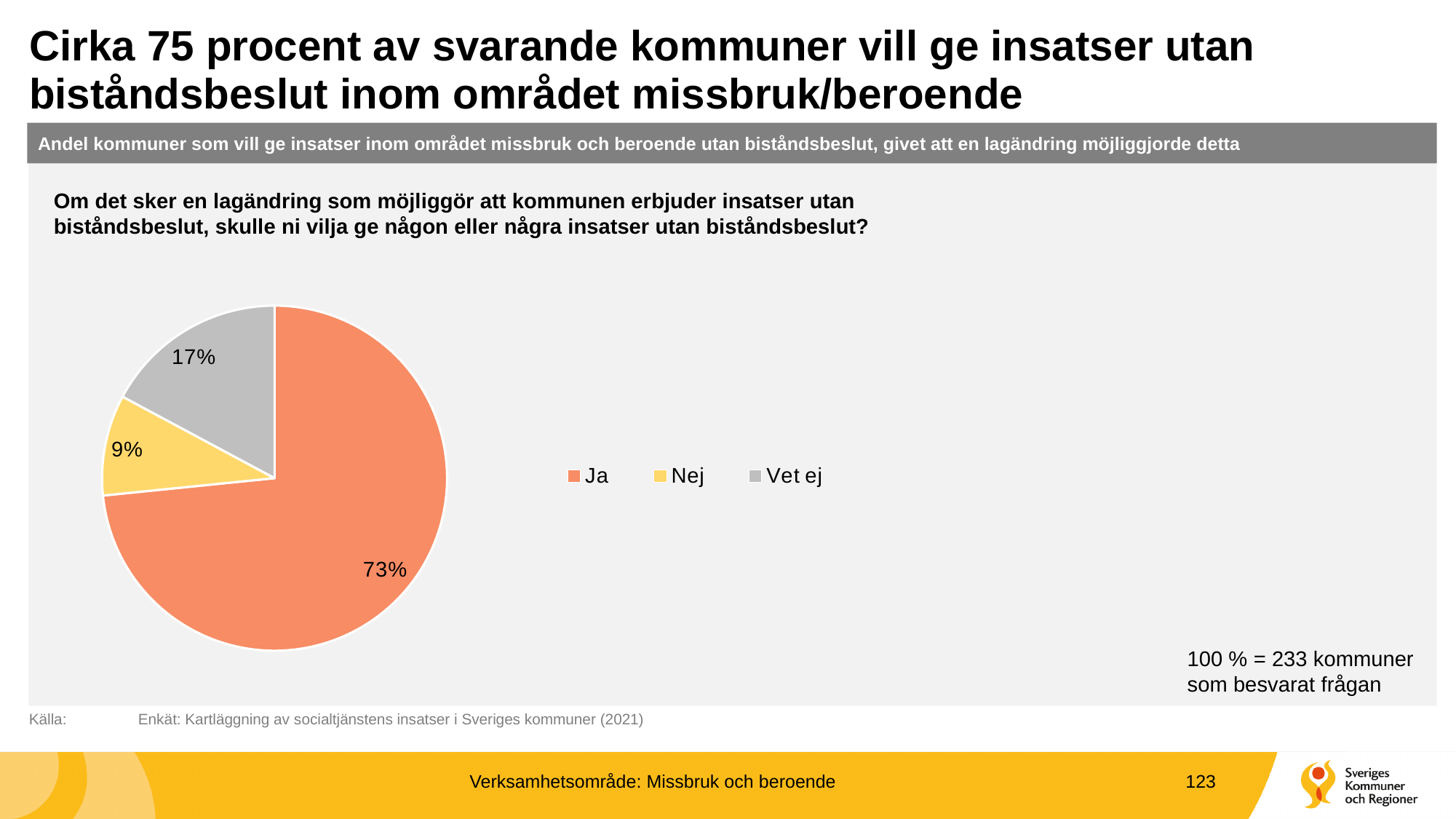
What share of the pie is labelled "Nej"? 9% Which is larger, the "Nej" slice or the "Vet ej" slice? Vet ej How many entries does the legend list? 3 What kind of chart is shown on the slide? pie chart How many slices does the pie chart have? 3 Which category has the largest slice of the pie? Ja Which category has the smallest slice of the pie? Nej What share of the pie is labelled "Ja"? 73% What share of the pie is labelled "Vet ej"? 17% What colour is the "Ja" slice in the pie chart? orange What is the difference in percentage points between the "Vet ej" slice and the "Nej" slice? 8 What is the difference in percentage points between the "Ja" slice and the "Vet ej" slice? 56